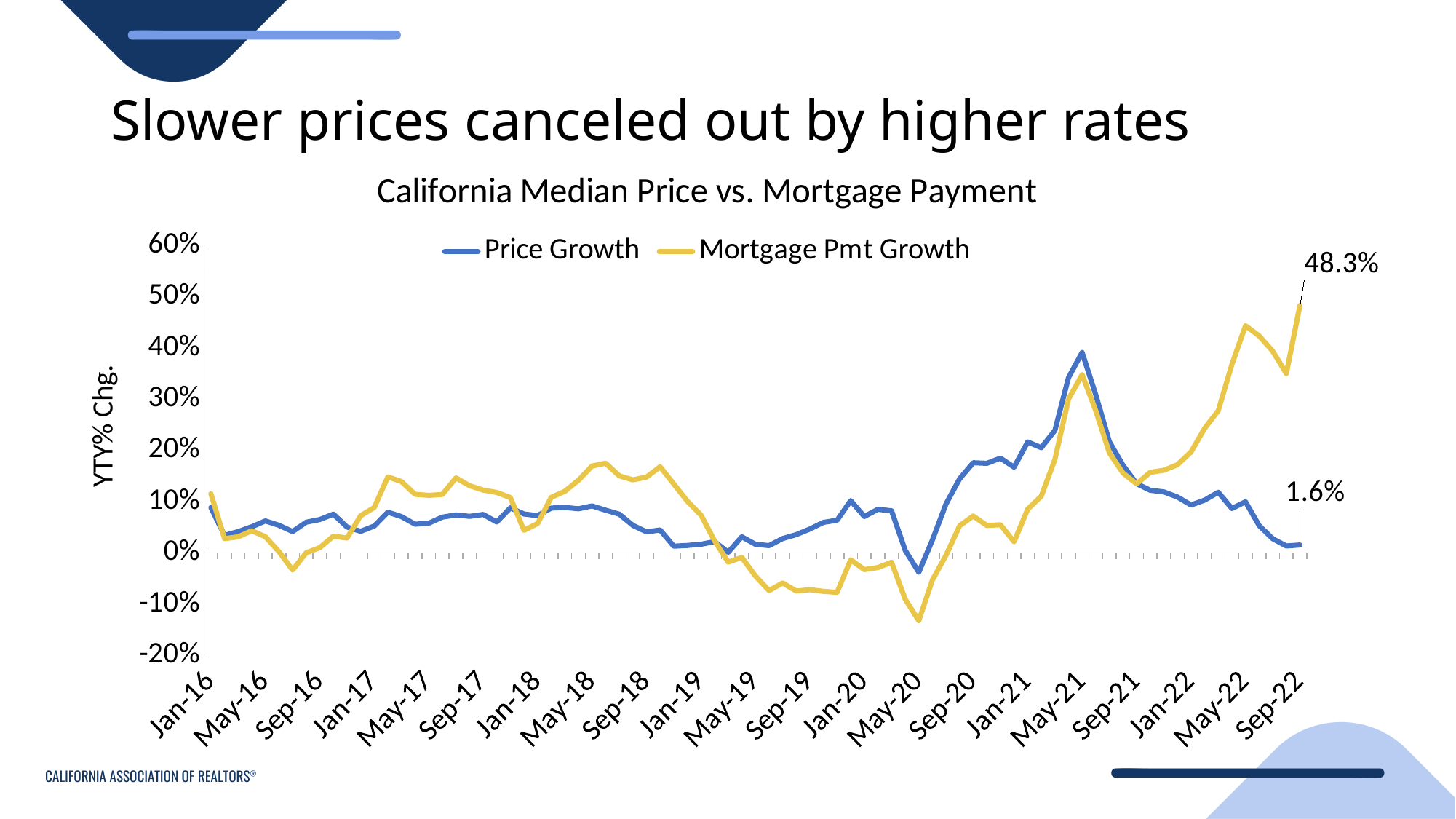
What is the Mortgage Pmt Growth value labeled at Sep-22? 48.3% Is the Price Growth value at May-21 greater or less than 30%? greater At Sep-22, which series has the larger value, Price Growth or Mortgage Pmt Growth? Mortgage Pmt Growth What kind of chart is shown on the slide? Line chart What is the label on the vertical axis of the chart? YTY% Chg. Is the Mortgage Pmt Growth value at May-22 greater or less than 40%? greater What is the Price Growth value labeled at Sep-22? 1.6% How many series does the legend list? 2 Which series reaches the highest value anywhere on the chart? Mortgage Pmt Growth Does Mortgage Pmt Growth rise or fall between Sep-21 and Sep-22? Rise What is the difference between the labeled Mortgage Pmt Growth and Price Growth values at Sep-22? 46.7 percentage points Is the Mortgage Pmt Growth value at May-20 greater or less than -10%? less